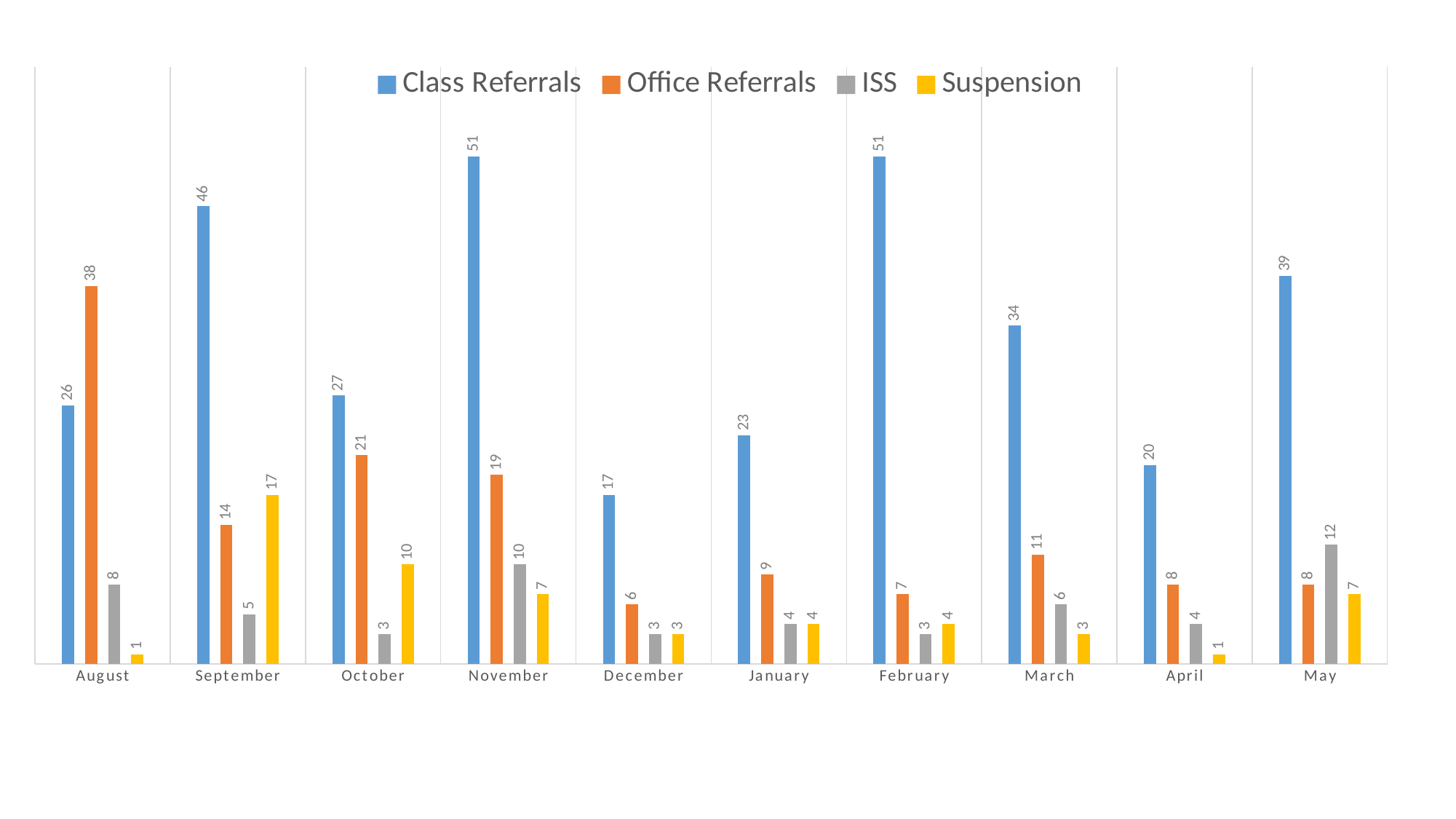
How many months are shown on the x axis? 10 What is the ISS value for May? 12 Which month has the highest Suspension value? September How many series does the legend list? 4 What is the value of Class Referrals for September? 46 What is the difference between Class Referrals and Office Referrals in November? 32 What kind of chart is shown on the slide? Bar chart Which month has the lowest Class Referrals value? December Which month has the highest Office Referrals value? August What is the Suspension value for October? 10 Which is larger in August: Class Referrals or Office Referrals? Office Referrals What is the value of Office Referrals for August? 38